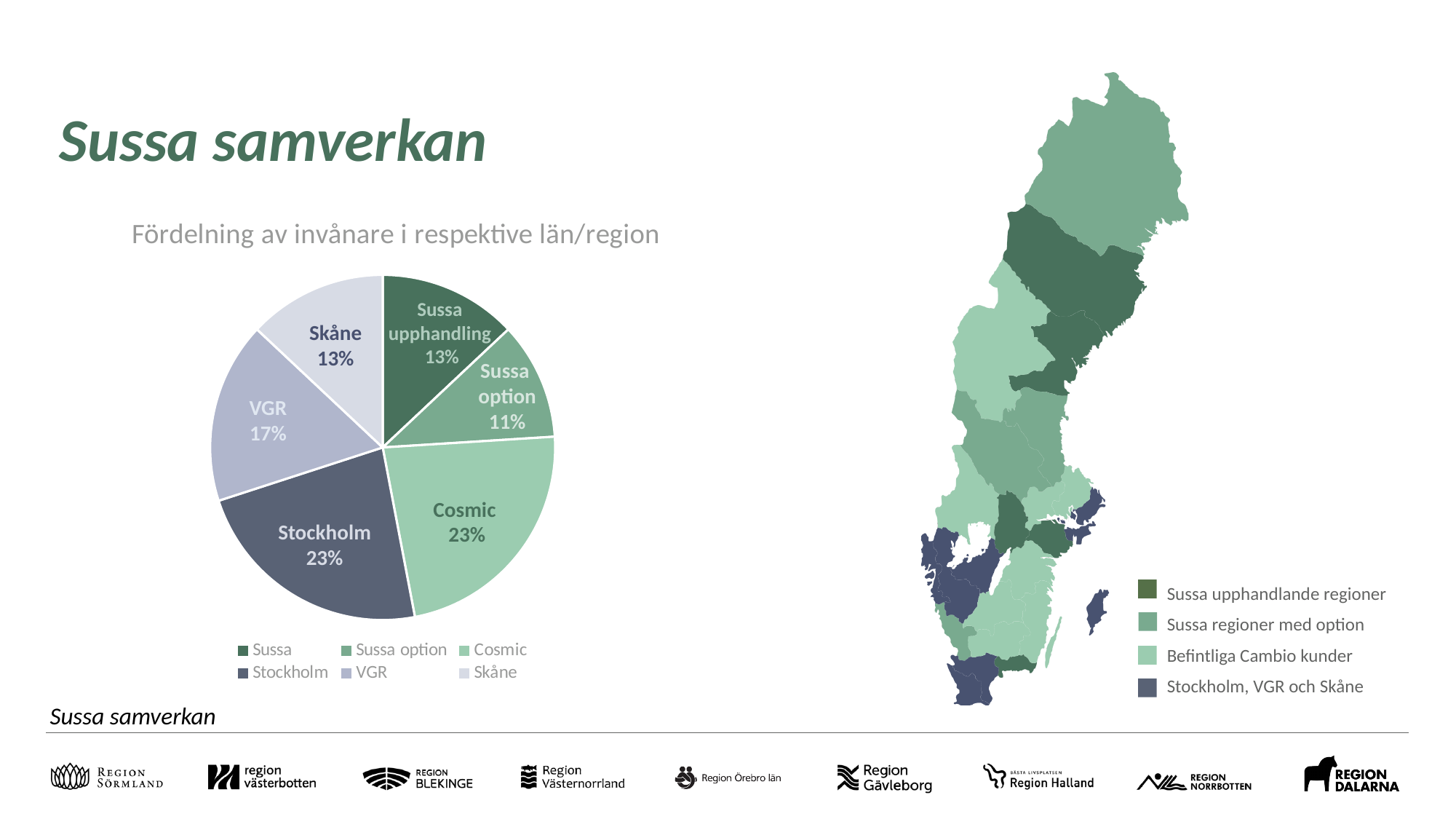
Which is larger, the share for VGR or the share for Skåne? VGR What share of the pie does Cosmic hold? 23% What is the difference in percentage points between VGR and Sussa option? 6 What percentage is shown for Sussa option? 11% What percentage is shown for Skåne in the pie chart? 13% How many slices does the pie chart have? 6 What type of chart is used to show the distribution of inhabitants? Pie chart Which slice of the pie chart is the smallest? Sussa option What percentage is shown for VGR in the pie chart? 17% What is the difference in percentage points between Stockholm and Skåne? 10 How many entries does the pie chart legend list? 6 What is the title of the pie chart? Fördelning av invånare i respektive län/region